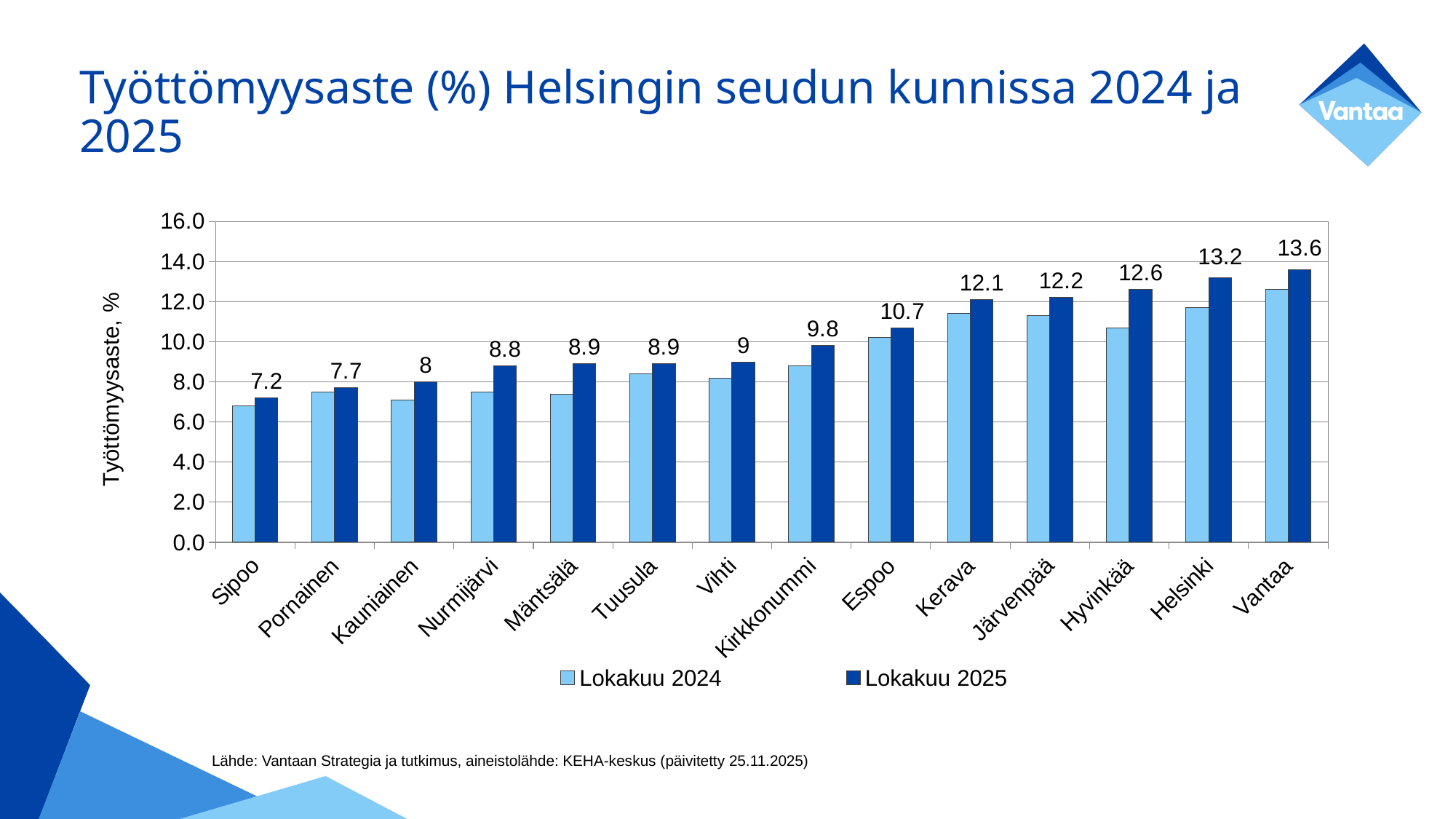
Which municipality has the highest unemployment rate in Lokakuu 2025? Vantaa Which municipality has the lowest unemployment rate in Lokakuu 2025? Sipoo Is the Lokakuu 2024 value for Helsinki greater or less than 10.0? greater What kind of chart is shown on the slide? Bar chart What is the difference between the Lokakuu 2025 unemployment rates of Vantaa and Sipoo? 6.4 Which has a higher unemployment rate in Lokakuu 2025, Espoo or Kerava? Kerava What is the unemployment rate for Vantaa in Lokakuu 2025? 13.6 Is the Lokakuu 2024 value for Sipoo greater or less than 8.0? less What is the unemployment rate for Helsinki in Lokakuu 2025? 13.2 How many municipalities are shown on the x axis of the chart? 14 What is the unemployment rate for Kirkkonummi in Lokakuu 2025? 9.8 How many series does the chart's legend list? 2